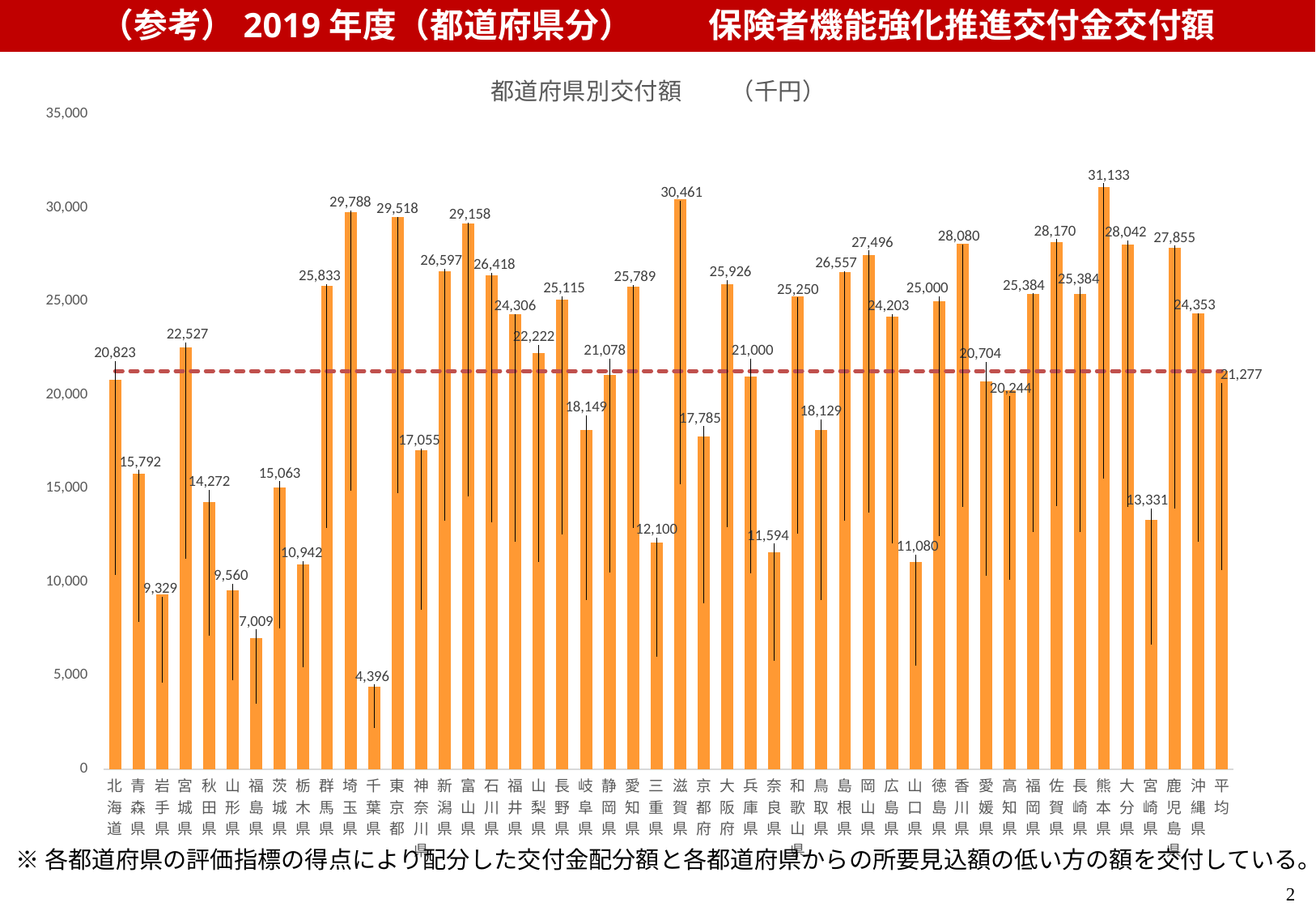
What is the difference between the values for 熊本県 and 千葉県? 26,737 What is the difference between the values for 滋賀県 and 埼玉県? 673 What kind of chart is shown on the slide? bar chart How many bars are plotted in the chart, including the 平均 bar? 48 Is the value for 福島県 greater or less than 10,000? less What is the value shown for 平均 (average) in the chart? 21,277 What is the value for 千葉県 in the chart? 4,396 What unit is given in the chart title? 千円 Which has a larger value, 東京都 or 埼玉県? 埼玉県 Which prefecture has the lowest value in the chart? 千葉県 What is the value for 北海道 in the chart? 20,823 Which prefecture has the highest value in the chart? 熊本県